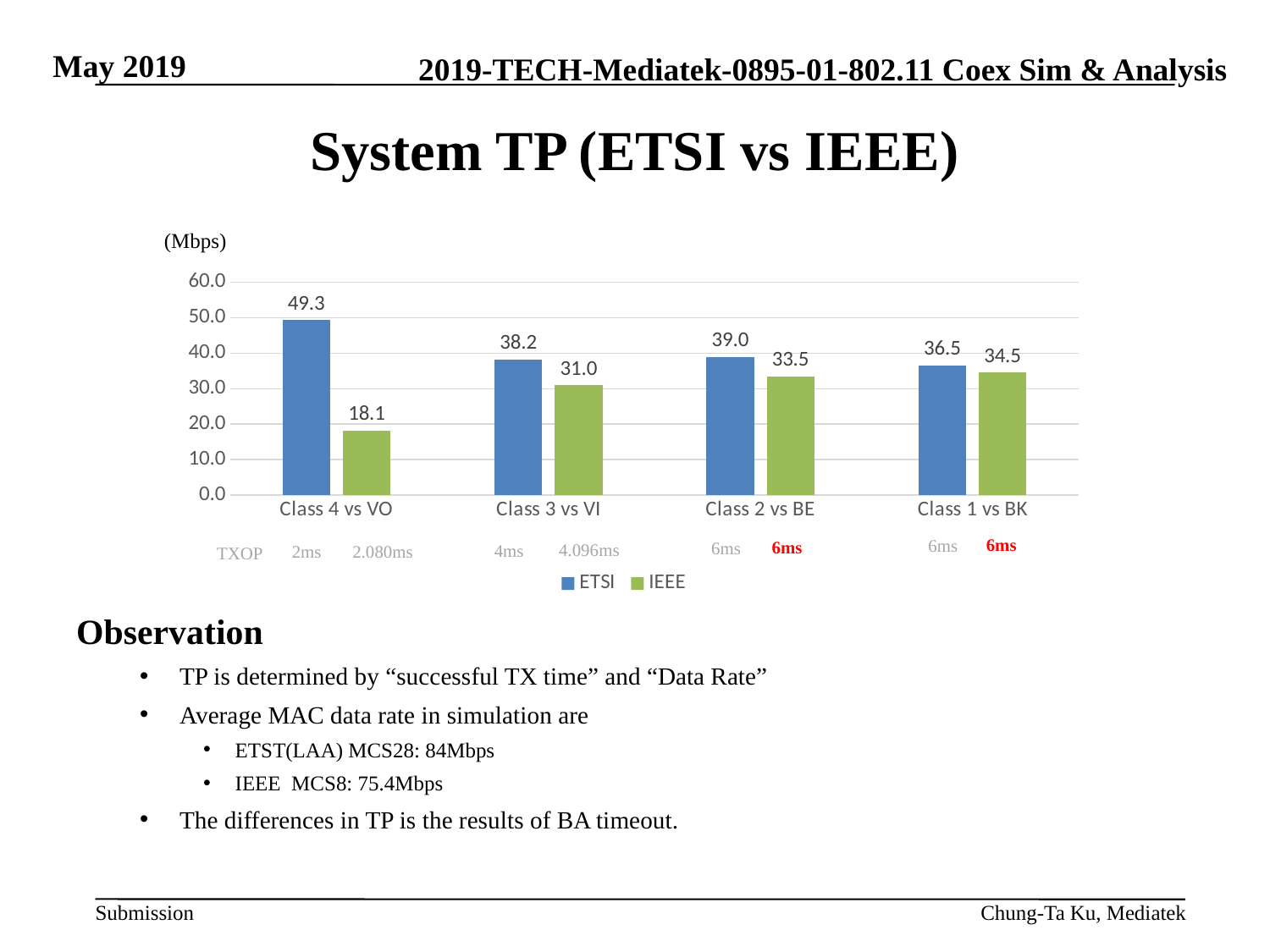
How many categories are shown on the x axis? 4 Which category has the lowest IEEE value? Class 4 vs VO What is the difference between the ETSI and IEEE values for Class 2 vs BE? 5.5 What is the ETSI value for Class 4 vs VO? 49.3 What is the IEEE value for Class 3 vs VI? 31.0 What is the ETSI value for Class 1 vs BK? 36.5 Which category has the highest ETSI value? Class 4 vs VO What kind of chart is shown on the slide? bar chart Which is larger for Class 3 vs VI, the ETSI value or the IEEE value? ETSI What unit is shown above the y axis of the chart? Mbps What is the IEEE value for Class 4 vs VO? 18.1 How many series does the legend list? 2